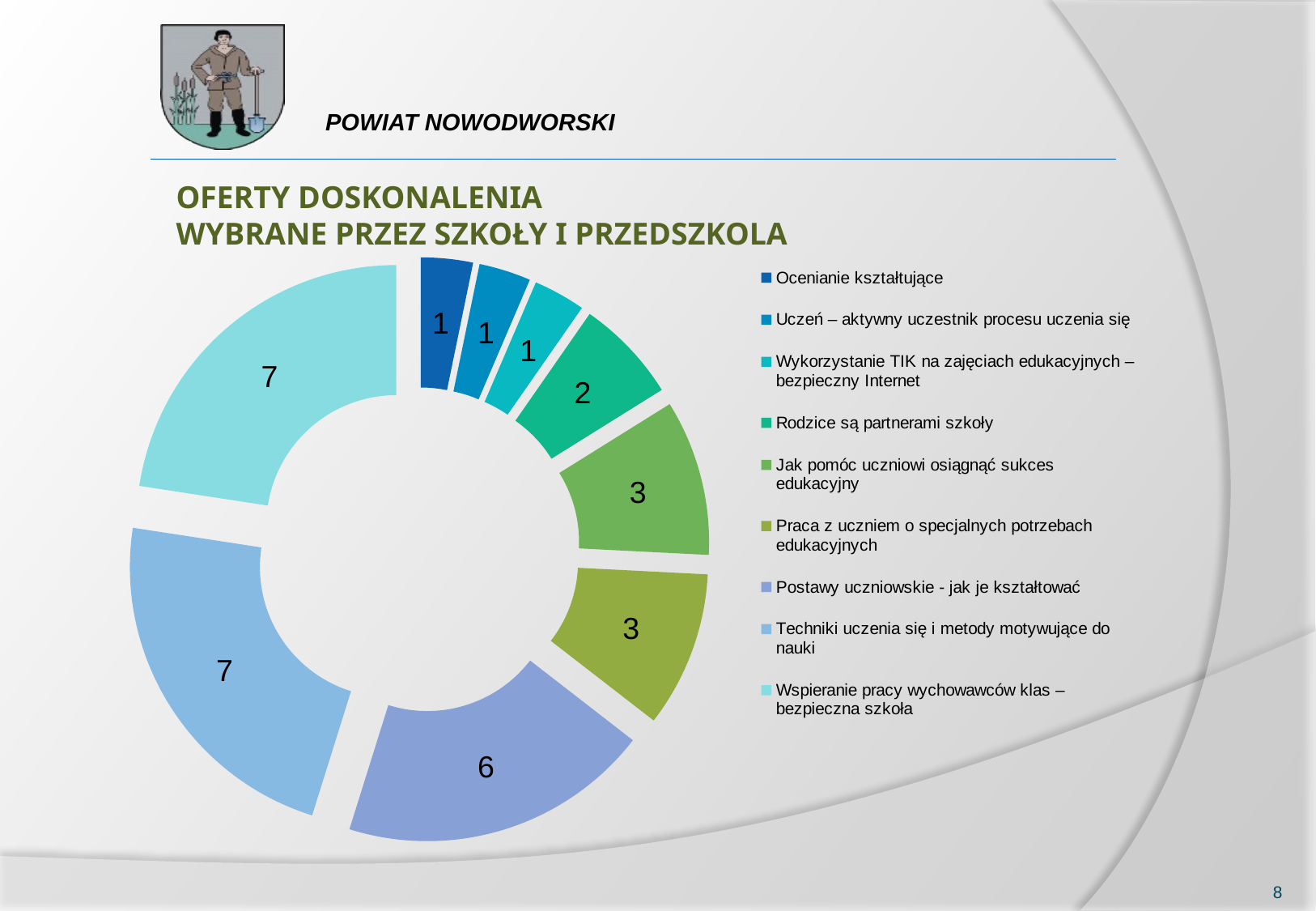
What value is shown for the segment "Ocenianie kształtujące"? 1 What is the title of the chart on the slide? OFERTY DOSKONALENIA WYBRANE PRZEZ SZKOŁY I PRZEDSZKOLA What value is shown for the segment "Rodzice są partnerami szkoły"? 2 What kind of chart is shown on the slide? Doughnut chart What value is shown for the segment "Techniki uczenia się i metody motywujące do nauki"? 7 What is the total of all the values shown on the chart? 31 What value is shown for the segment "Jak pomóc uczniowi osiągnąć sukces edukacyjny"? 3 What is the difference between the value for "Postawy uczniowskie - jak je kształtować" and the value for "Wykorzystanie TIK na zajęciach edukacyjnych – bezpieczny Internet"? 5 What value is shown for the segment "Postawy uczniowskie - jak je kształtować"? 6 How many categories does the chart show? 9 Which is larger: the value for "Postawy uczniowskie - jak je kształtować" or the value for "Rodzice są partnerami szkoły"? Postawy uczniowskie - jak je kształtować What is the difference between the value for "Wspieranie pracy wychowawców klas – bezpieczna szkoła" and the value for "Praca z uczniem o specjalnych potrzebach edukacyjnych"? 4